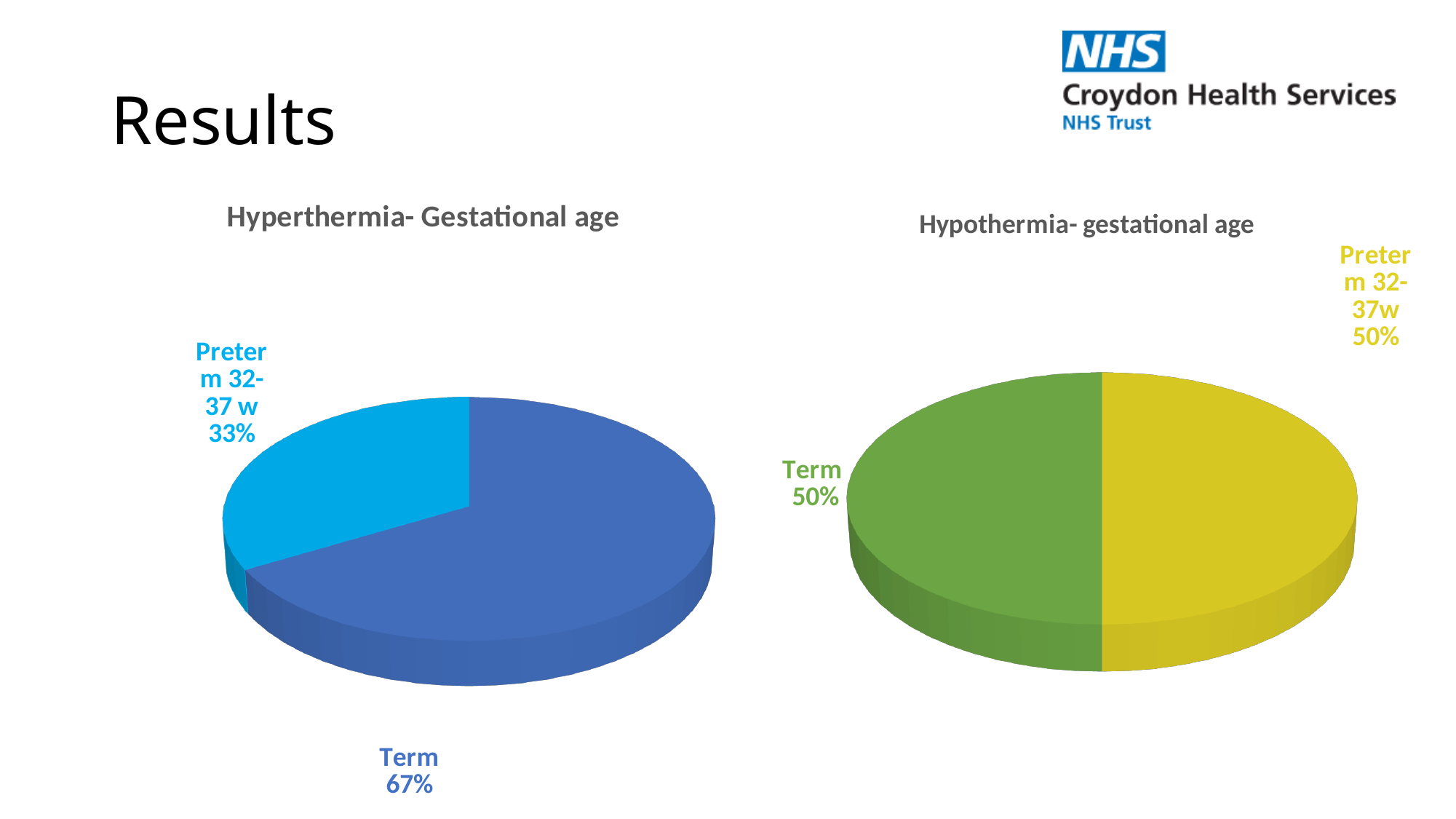
In the 'Hypothermia- gestational age' chart, what share of the pie is Term? 50% How many charts are shown on the slide? 2 What kind of chart is the 'Hypothermia- gestational age' chart? Pie chart In the 'Hyperthermia- Gestational age' chart, what is the difference in percentage points between Term and Preterm 32-37 w? 34 In the 'Hypothermia- gestational age' chart, what share of the pie is Preterm 32-37w? 50% What colour is the Term slice in the 'Hypothermia- gestational age' chart? Green In the 'Hyperthermia- Gestational age' chart, which category has the largest slice? Term In the 'Hyperthermia- Gestational age' chart, which is larger, Term or Preterm 32-37 w? Term In the 'Hyperthermia- Gestational age' chart, what share of the pie is Preterm 32-37 w? 33% How many slices does the 'Hypothermia- gestational age' pie chart have? 2 In the 'Hyperthermia- Gestational age' chart, which category has the smallest slice? Preterm 32-37 w